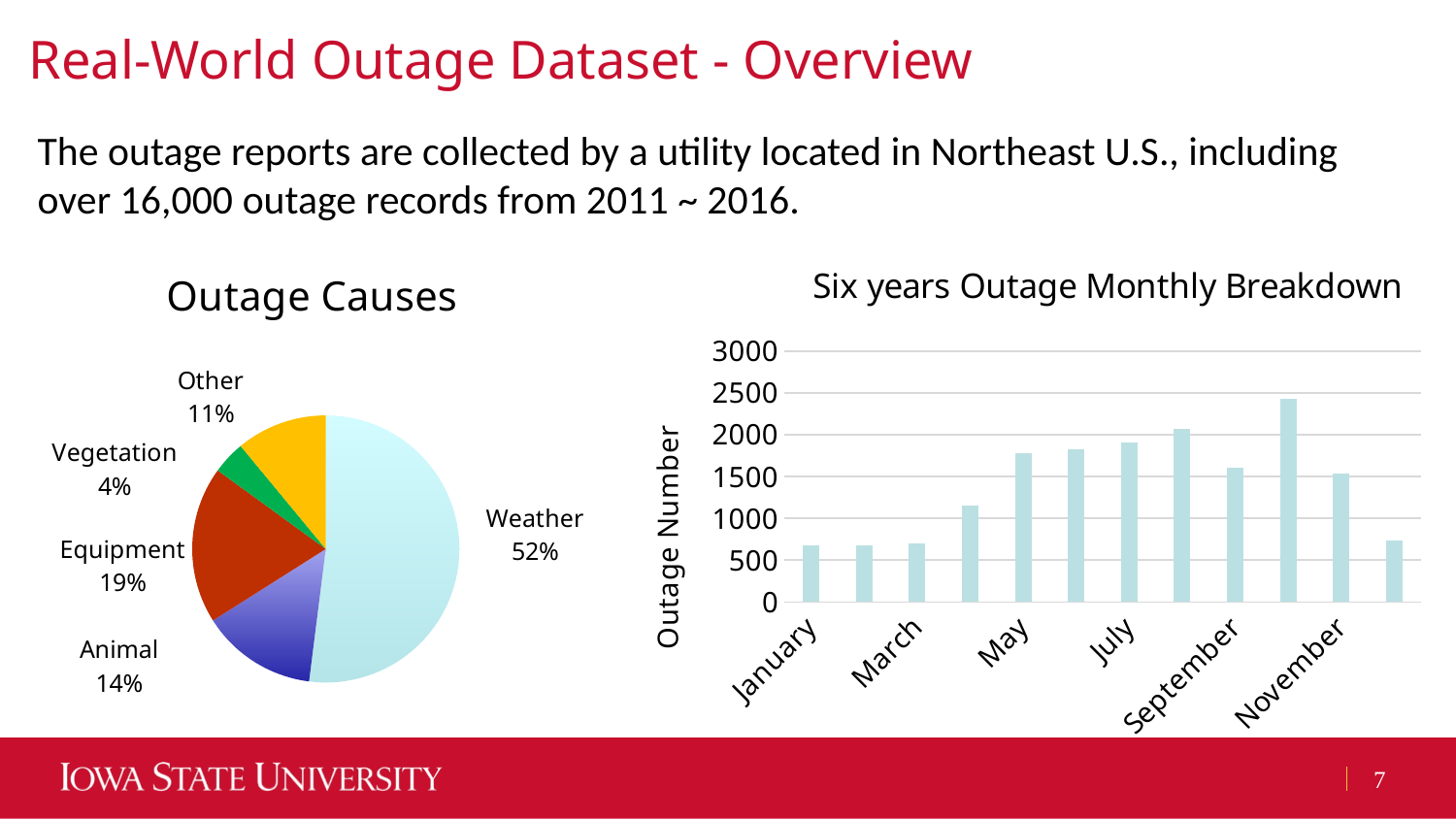
In the Six years Outage Monthly Breakdown chart, is the value for July greater or less than 1500? greater How many bars are plotted in the Six years Outage Monthly Breakdown chart? 12 In the Outage Causes pie chart, what share of outages is caused by Equipment? 19% In the Outage Causes pie chart, which cause has the smallest share? Vegetation What type of chart is the Six years Outage Monthly Breakdown chart? Bar chart In the Outage Causes pie chart, which cause has the largest share? Weather In the Outage Causes pie chart, what is the difference in percentage points between Equipment and Animal? 5 In the Outage Causes pie chart, which is larger, the share for Other or the share for Animal? Animal How many categories are shown in the Outage Causes pie chart? 5 What is the y-axis label of the Six years Outage Monthly Breakdown chart? Outage Number In the Outage Causes pie chart, what percentage of outages is attributed to Weather? 52% In the Six years Outage Monthly Breakdown chart, is the value for January greater or less than 1000? less